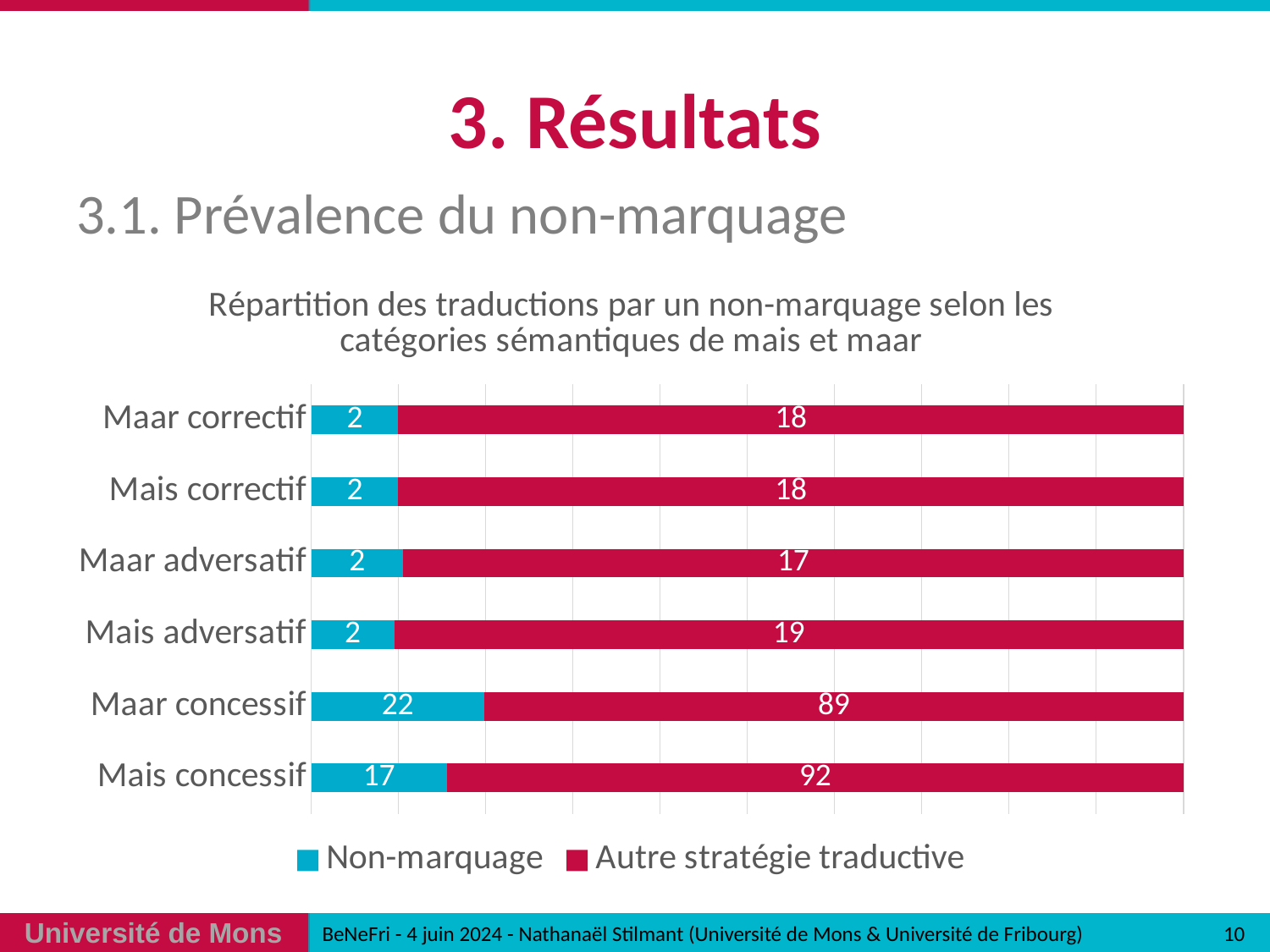
What is the Non-marquage value for Maar concessif? 22 Which category has the highest Autre stratégie traductive value? Mais concessif What is the Autre stratégie traductive value for Mais concessif? 92 What is the total of the stacked bar for Maar concessif? 111 Which category has the lowest Autre stratégie traductive value? Maar adversatif What is the difference between the Autre stratégie traductive values for Mais concessif and Maar concessif? 3 What is the Autre stratégie traductive value for Maar adversatif? 17 How many categories are shown on the chart? 6 What is the Non-marquage value for Mais correctif? 2 Which is larger: the Non-marquage value for Maar concessif or for Mais concessif? Maar concessif How many series does the legend list? 2 What kind of chart is shown on the slide? Stacked bar chart